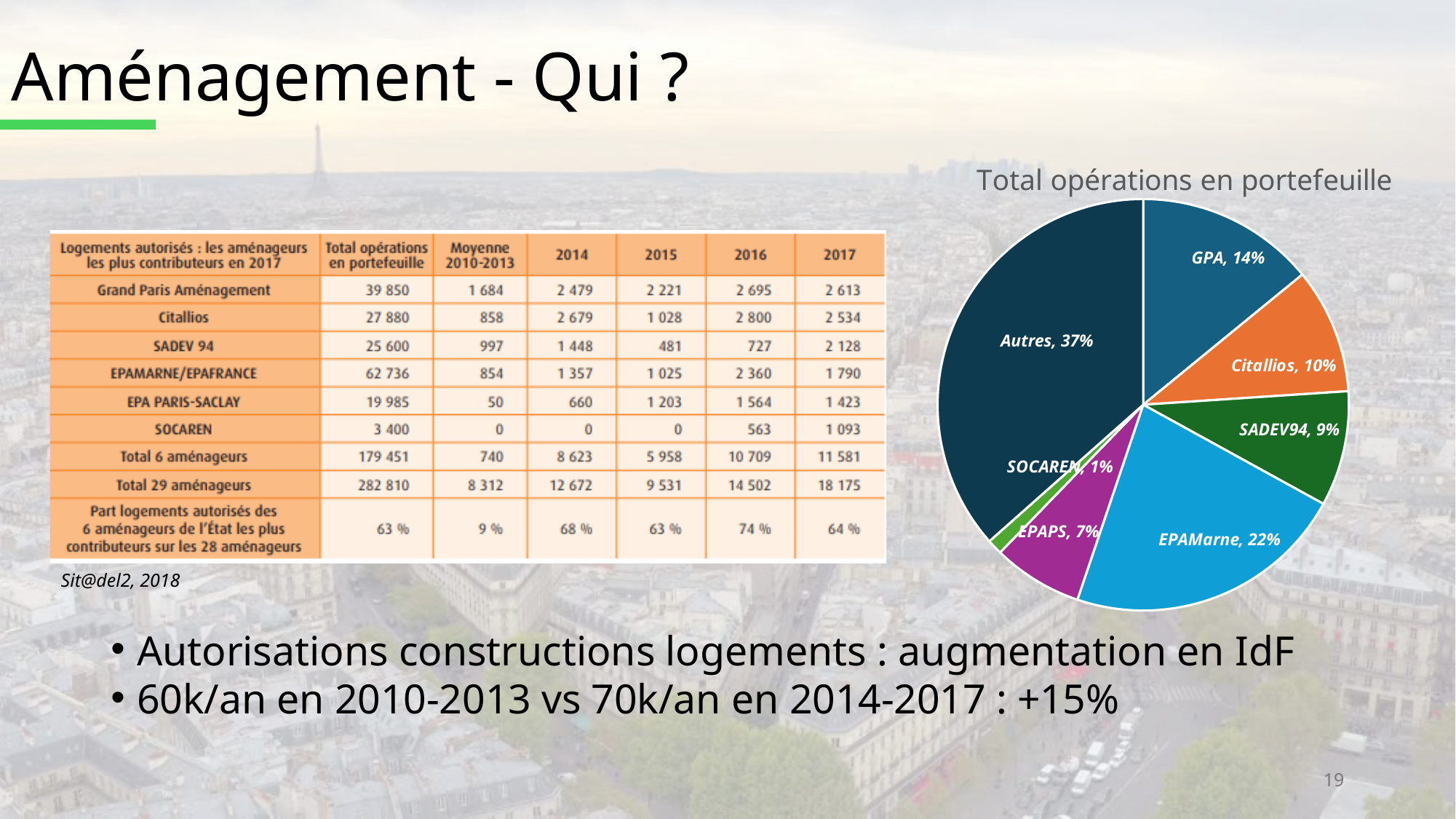
Which slice of the pie chart is the largest? Autres What kind of chart is shown on the right of the slide? pie chart In the pie chart, what share does SOCAREN have? 1% What is the title of the pie chart? Total opérations en portefeuille In the pie chart, which is larger: the share of SADEV94 or the share of EPAPS? SADEV94 Which slice of the pie chart is the smallest? SOCAREN In the pie chart, what is the combined share of GPA and Citallios? 24% In the pie chart, what share does Citallios have? 10% In the pie chart, what share does GPA have? 14% How many slices does the pie chart have? 7 In the pie chart, what share does EPAMarne have? 22% In the pie chart, what is the difference between the share of EPAMarne and the share of GPA? 8%